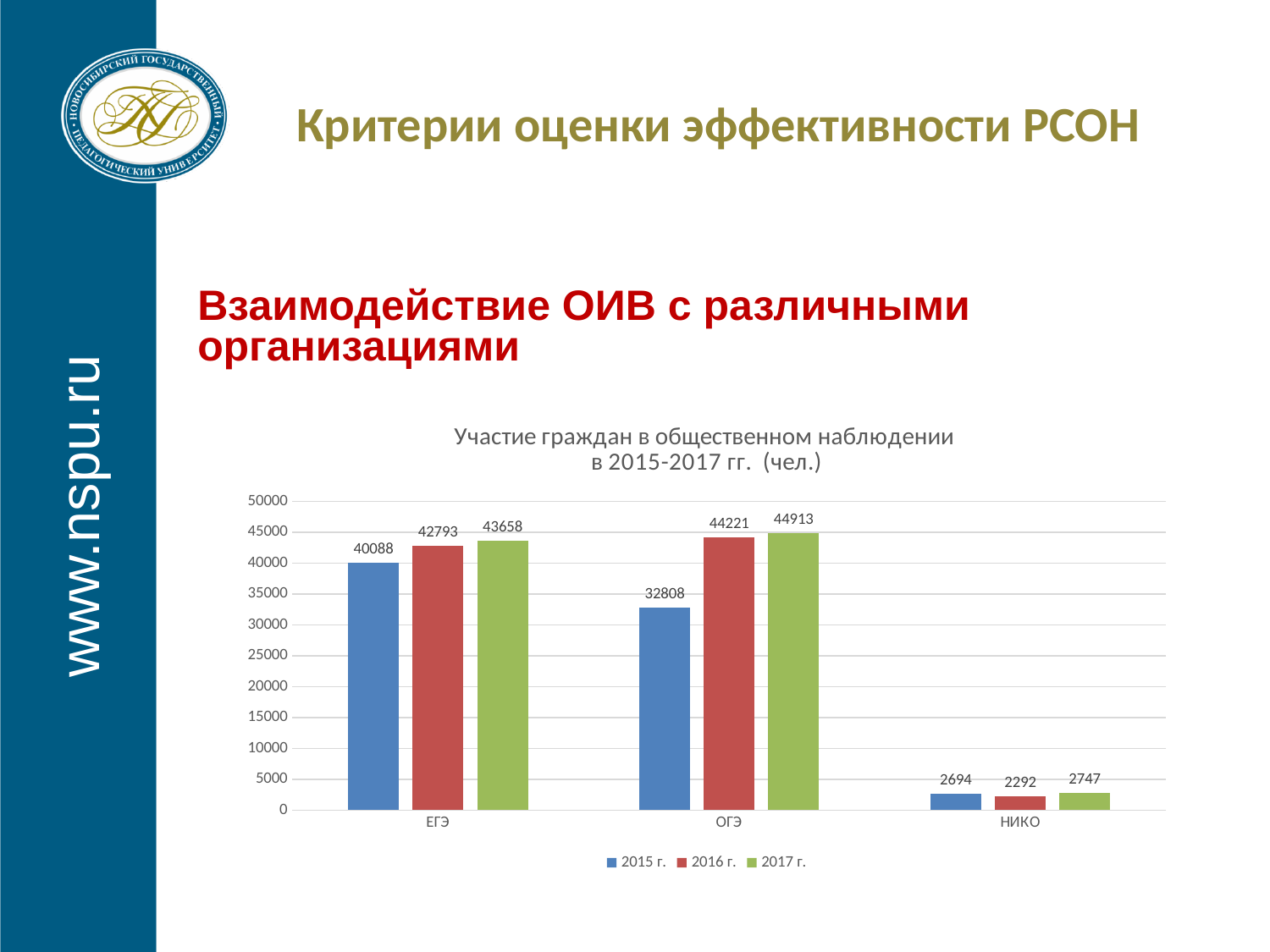
How many series does the legend list? 3 Which category has the highest value in 2017 г.? ОГЭ How many categories are shown on the x axis? 3 Which is larger for ЕГЭ: the 2016 г. value or the 2017 г. value? 2017 г. What is the difference between the 2017 г. and 2015 г. values for ОГЭ? 12105 What kind of chart is shown? bar chart Which category has the lowest value in 2015 г.? НИКО What is the value for НИКО in 2016 г.? 2292 Do the values for ЕГЭ rise or fall from 2015 г. to 2017 г.? rise What is the value for ОГЭ in 2017 г.? 44913 Is the value for ОГЭ in 2015 г. greater or less than 35000? less What is the value for ЕГЭ in 2015 г.? 40088